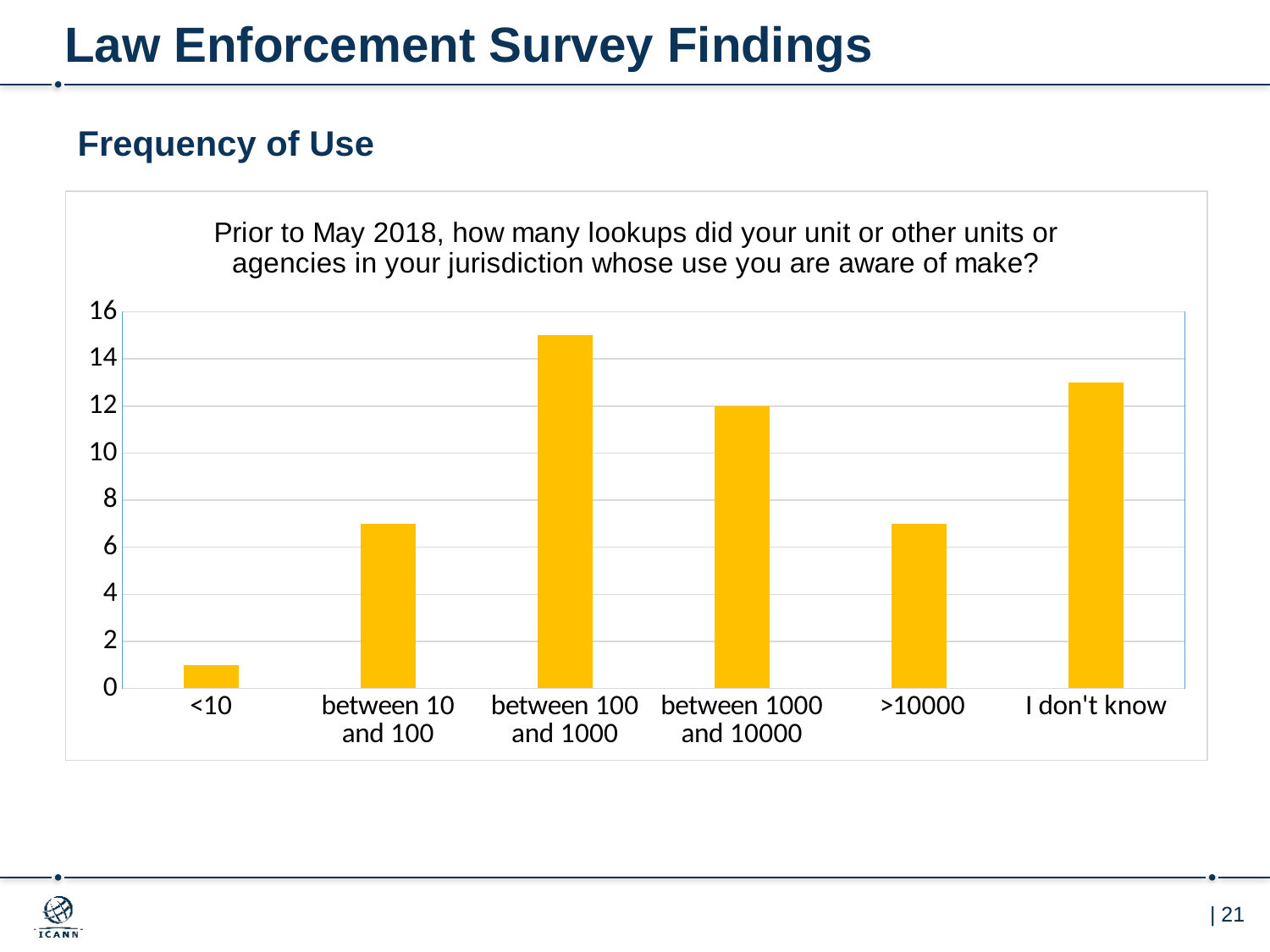
Is the value for '<10' greater or less than 2? less Is the value for 'between 10 and 100' greater or less than 6? greater How many categories are shown on the x axis of the chart? 6 Is the value for '>10000' greater or less than 8? less Which category has the highest value in the chart? between 100 and 1000 What is the value for the category 'between 1000 and 10000'? 12 Which is larger, the value for 'between 100 and 1000' or the value for 'I don't know'? between 100 and 1000 What type of chart is shown on the slide? bar chart What is the title of the chart? Prior to May 2018, how many lookups did your unit or other units or agencies in your jurisdiction whose use you are aware of make? Which category has the lowest value in the chart? <10